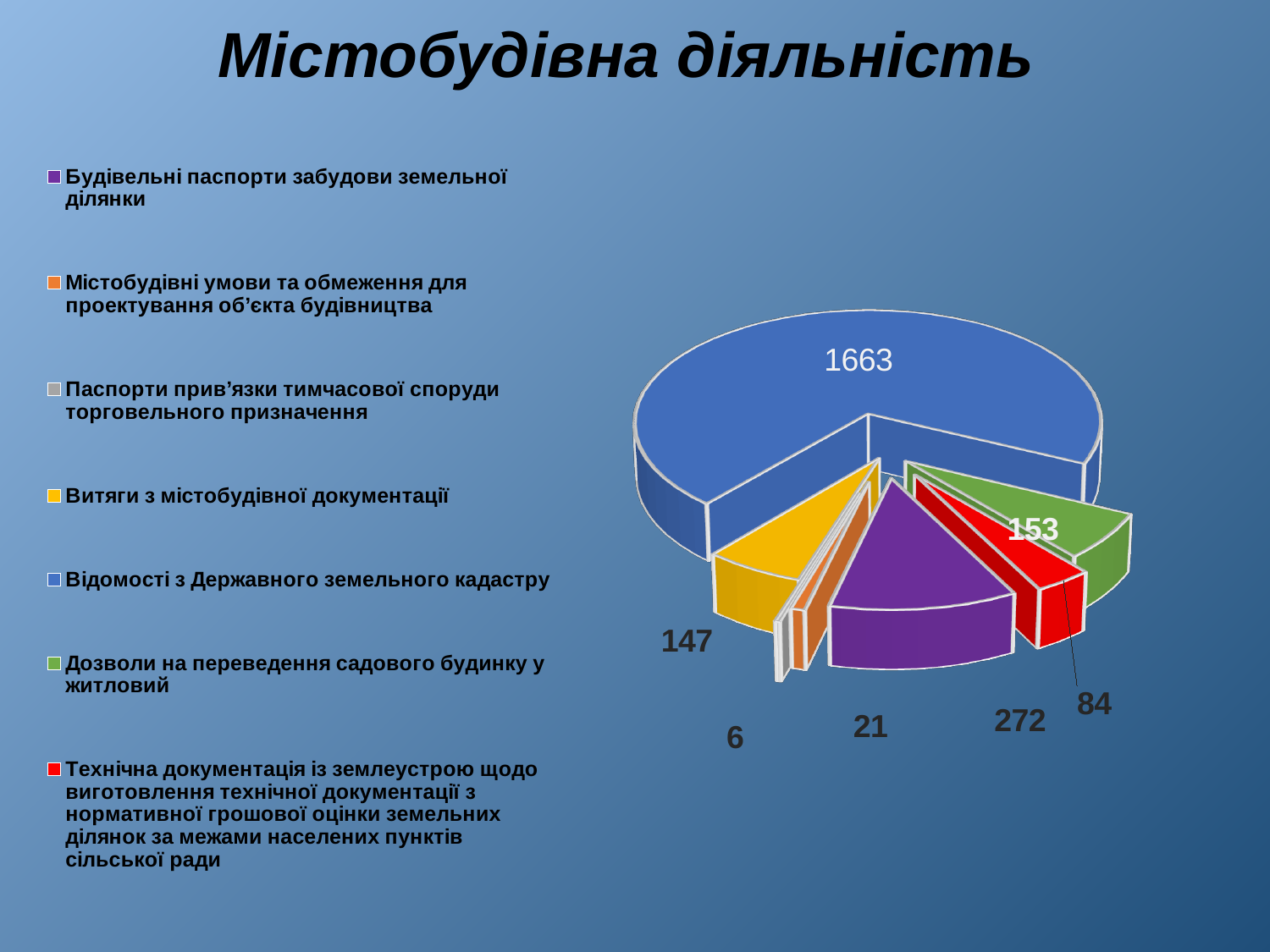
Which category has the smallest slice of the pie? Паспорти прив’язки тимчасової споруди торговельного призначення What is the difference between the values for Будівельні паспорти забудови земельної ділянки and Дозволи на переведення садового будинку у житловий? 119 What kind of chart is shown on the slide? pie chart How many categories does the legend of the pie chart list? 7 What is the value for Відомості з Державного земельного кадастру? 1663 What colour is the slice for Відомості з Державного земельного кадастру? blue What is the value for Витяги з містобудівної документації? 147 Which category has the largest slice of the pie? Відомості з Державного земельного кадастру Which is larger: the value for Містобудівні умови та обмеження для проектування об’єкта будівництва or the value for Технічна документація із землеустрою? Технічна документація із землеустрою What is the value for Будівельні паспорти забудови земельної ділянки? 272 What is the value for Паспорти прив’язки тимчасової споруди торговельного призначення? 6 What is the value for Дозволи на переведення садового будинку у житловий? 153